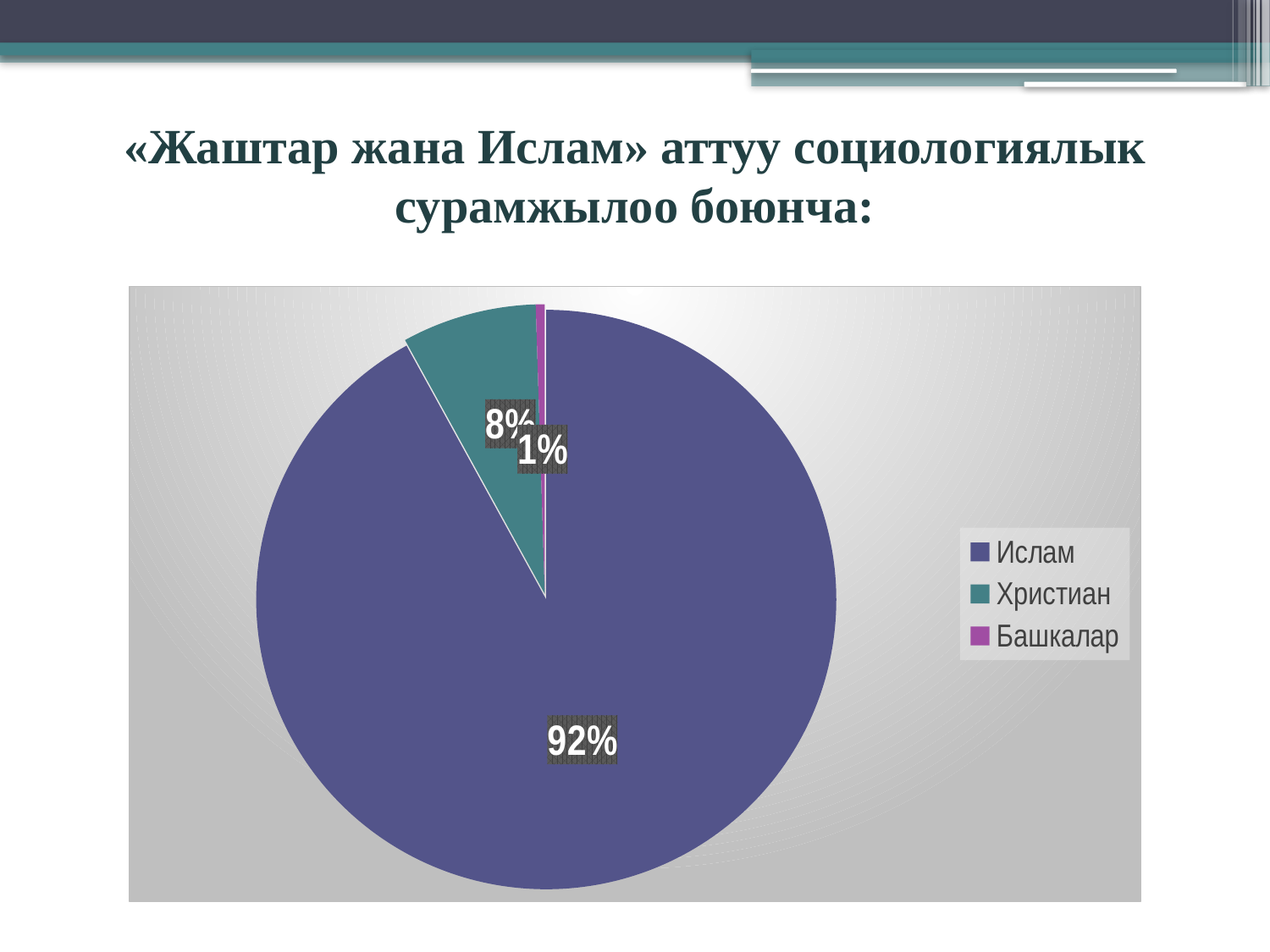
What is the difference between the shares of Ислам and Христиан? 84% Which category has the smallest slice of the pie? Башкалар What share of the pie does Башкалар have? 1% What share of the pie does Ислам have? 92% What kind of chart is shown on the slide? pie chart How many categories does the legend list? 3 What colour is the slice for Башкалар? purple/magenta Is the share for Ислам greater or less than 50%? greater Which category has the largest slice of the pie? Ислам Which is larger, the share of Христиан or the share of Башкалар? Христиан What share of the pie does Христиан have? 8% What is the difference between the shares of Христиан and Башкалар? 7%